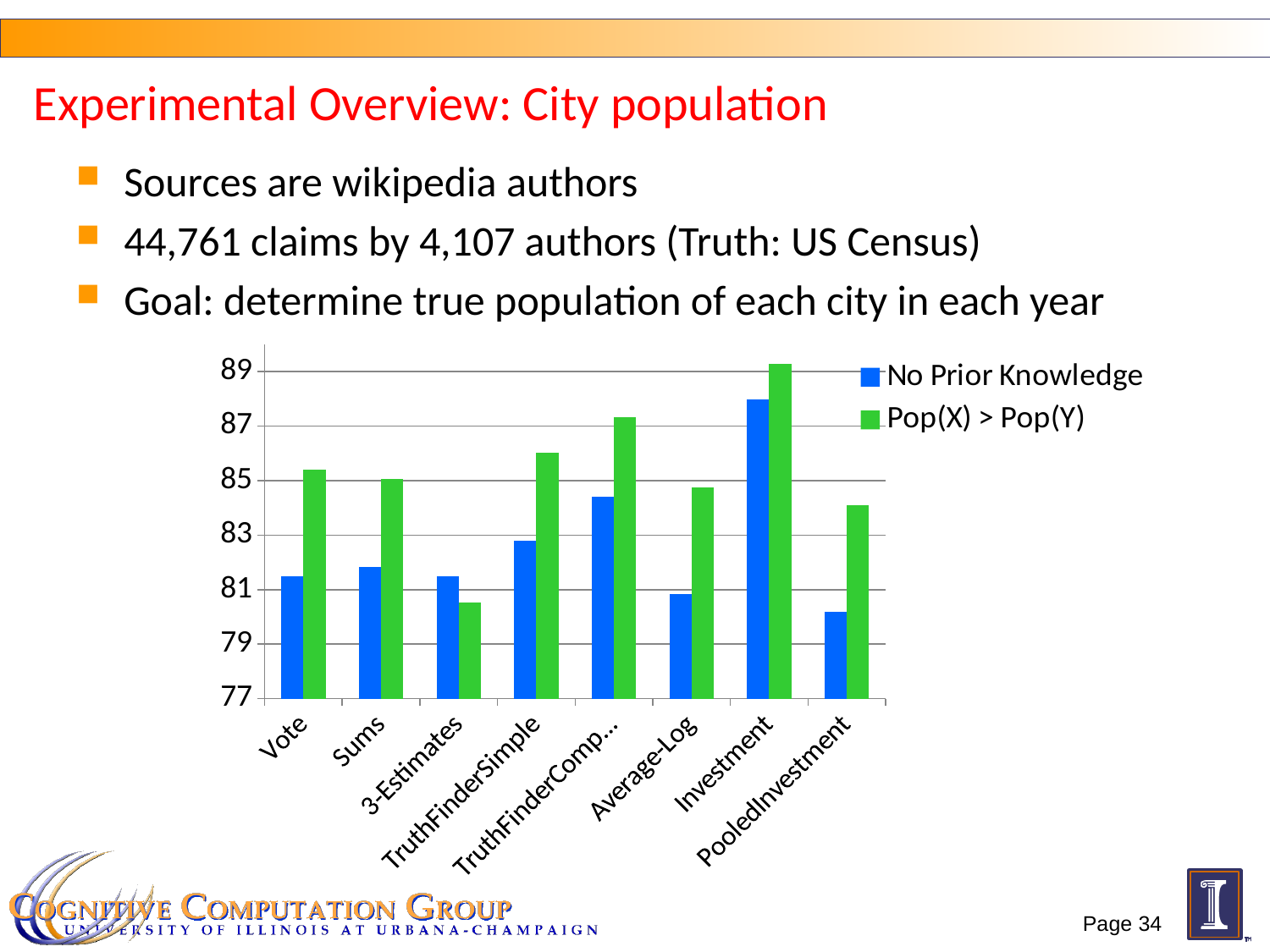
For Vote, which series has the larger value, No Prior Knowledge or Pop(X) > Pop(Y)? Pop(X) > Pop(Y) Which category has the lowest value for the Pop(X) > Pop(Y) series? 3-Estimates How many categories are shown on the x axis of the chart? 8 Which category has the highest value for the Pop(X) > Pop(Y) series? Investment What kind of chart is shown on the slide? bar chart How many series does the legend list? 2 Is the No Prior Knowledge value for Investment greater or less than 87? greater Which category has the highest value for the No Prior Knowledge series? Investment Is the No Prior Knowledge value for Average-Log greater or less than 83? less Which colour represents the No Prior Knowledge series in the chart? blue For 3-Estimates, which series has the larger value, No Prior Knowledge or Pop(X) > Pop(Y)? No Prior Knowledge Is the Pop(X) > Pop(Y) value for 3-Estimates greater or less than 81? less